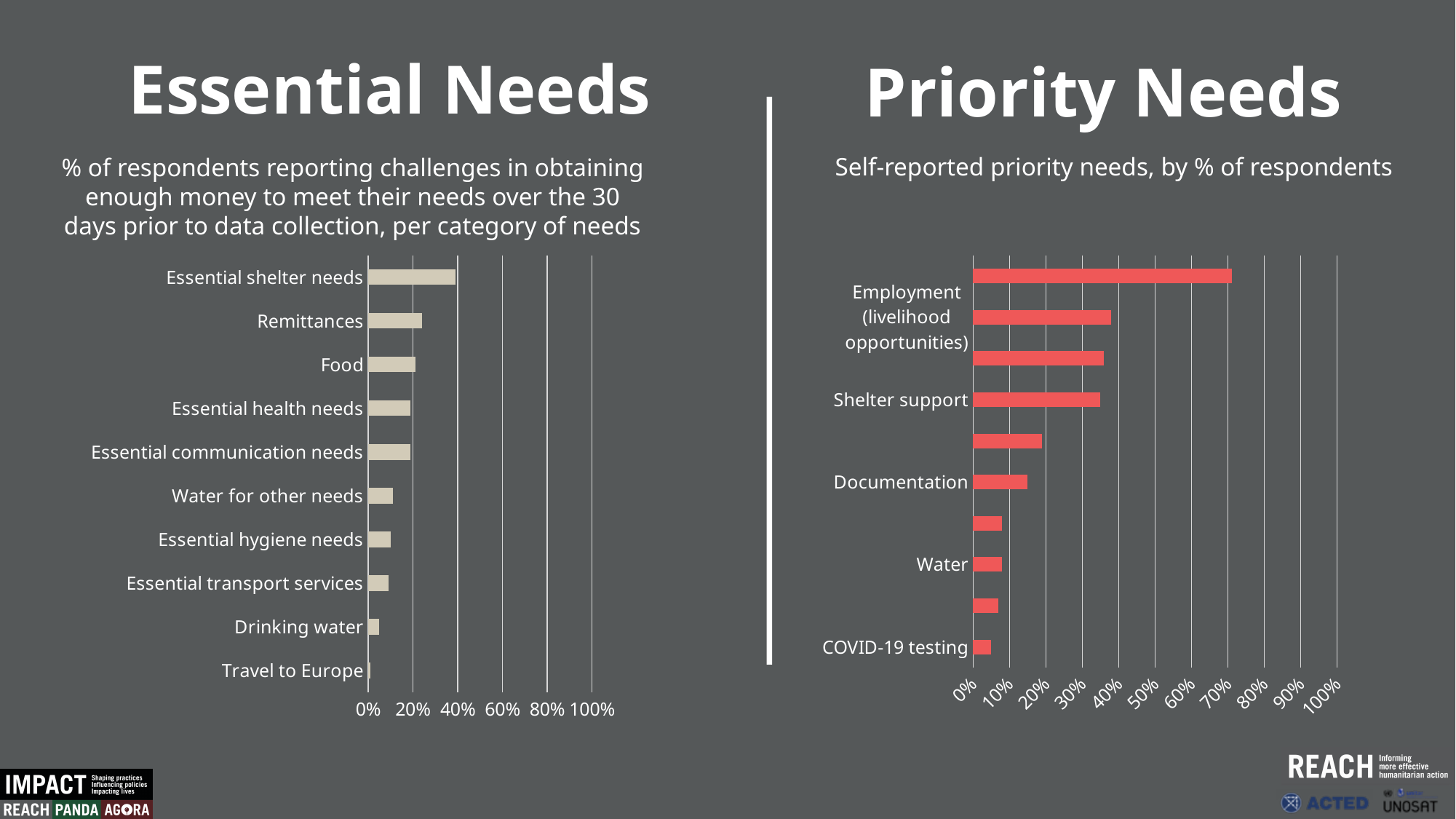
What kind of chart is the Essential Needs chart? Bar chart On the Essential Needs chart, which is larger, the value for Remittances or the value for Drinking water? Remittances What is the highest value shown on the x axis of the Priority Needs chart? 100% On the Essential Needs chart, how many categories are plotted? 10 On the Essential Needs chart, which category has the highest value? Essential shelter needs On the Essential Needs chart, is the value for Water for other needs greater or less than 20%? less On the Priority Needs chart, is the value for Shelter support greater or less than 30%? greater On the Priority Needs chart, is the value for COVID-19 testing greater or less than 10%? less On the Essential Needs chart, which category has the lowest value? Travel to Europe